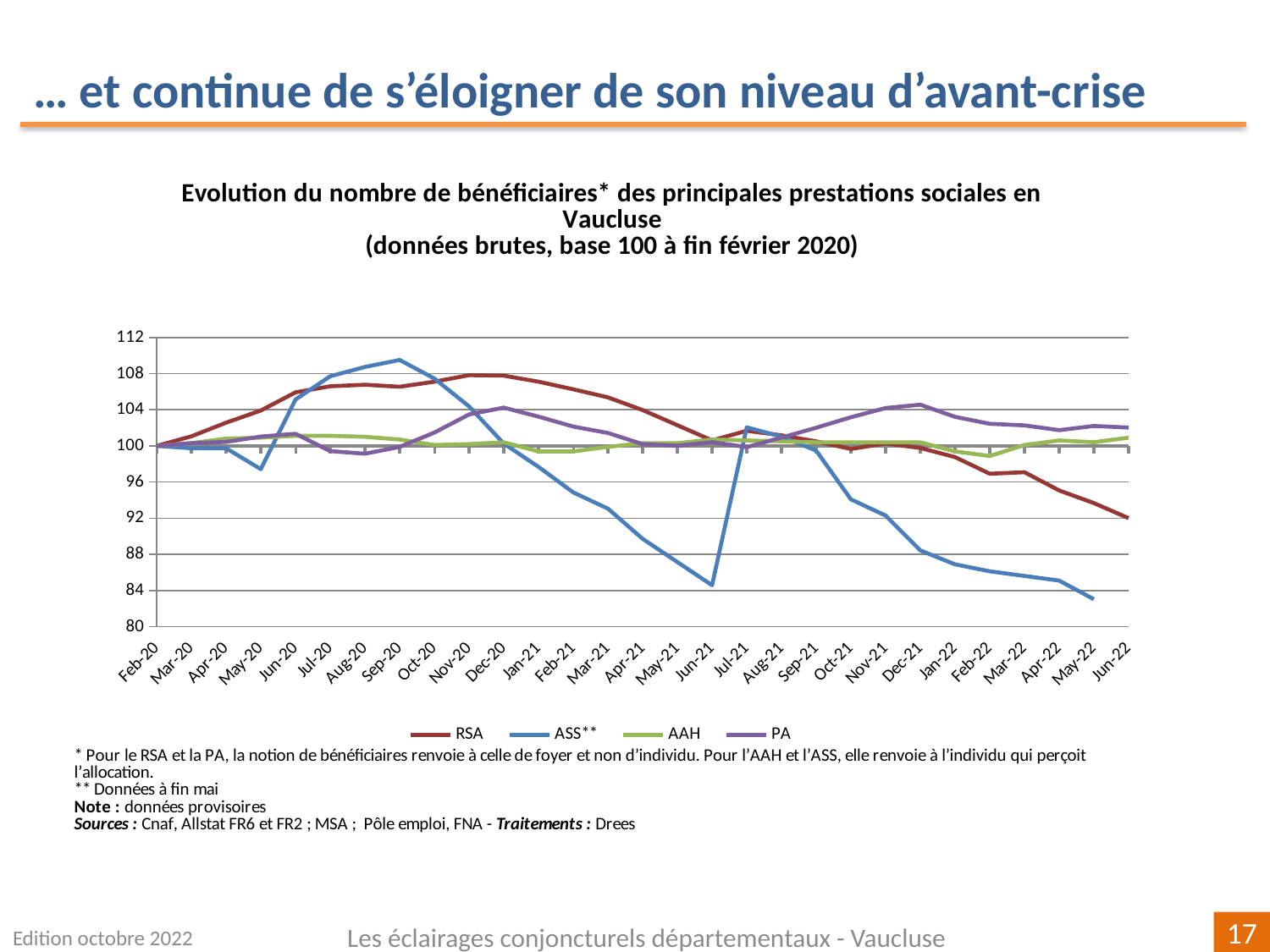
What is the base period of the index (base 100) according to the chart title? fin février 2020 In Jun-22, which is larger, the value for RSA or the value for AAH? AAH How many series does the legend list? 4 Is the value for RSA in Jun-22 greater or less than 96? less Is the value for RSA in Nov-20 greater or less than 104? greater Does the ASS** series rise or fall between Jul-21 and May-22? fall Which series has the lowest value in Jun-21? ASS** Is the value for ASS** in Jun-21 greater or less than 88? less Which series has the highest value in Sep-20? ASS** How many monthly points are shown on the x axis, from Feb-20 to Jun-22? 29 What kind of chart is shown on the slide? line chart